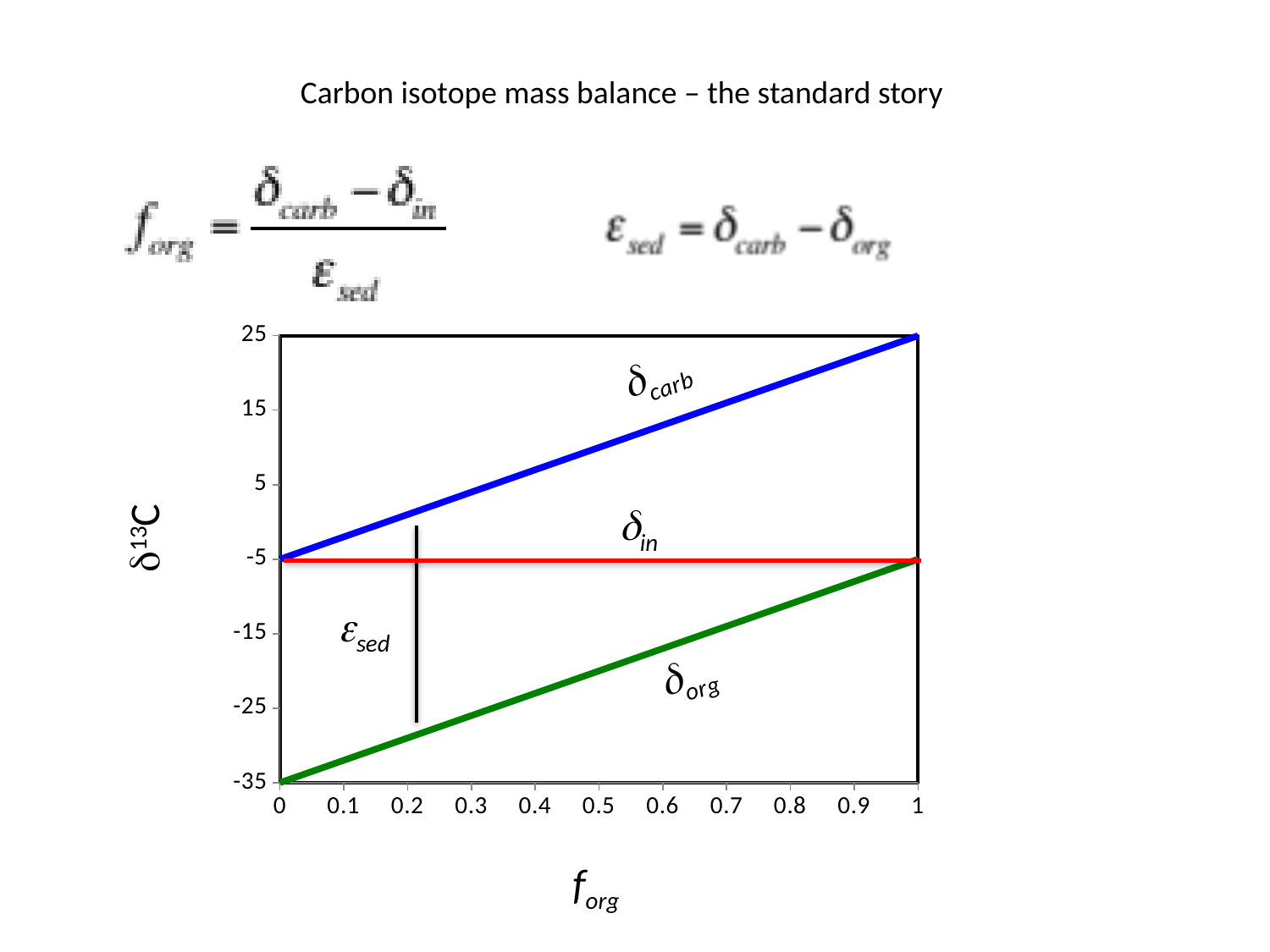
What kind of chart is shown on the slide? line chart Does the δin line rise, fall, or stay flat as f_org increases? stays flat How many lines are plotted on the chart? 3 Does the δcarb line rise or fall as f_org increases? rises Is the value of δorg at f_org = 0.5 greater or less than -15? less What is the difference between δcarb and δorg at f_org = 1? 30 What constant value does the δin line have? -5 What is the value of δorg at f_org = 0? -35 What colour is the δin line? red Which line has the highest values across the chart: δcarb, δin, or δorg? δcarb What is the value of δcarb at f_org = 1? 25 At f_org = 0.5, which is larger, δcarb or δorg? δcarb